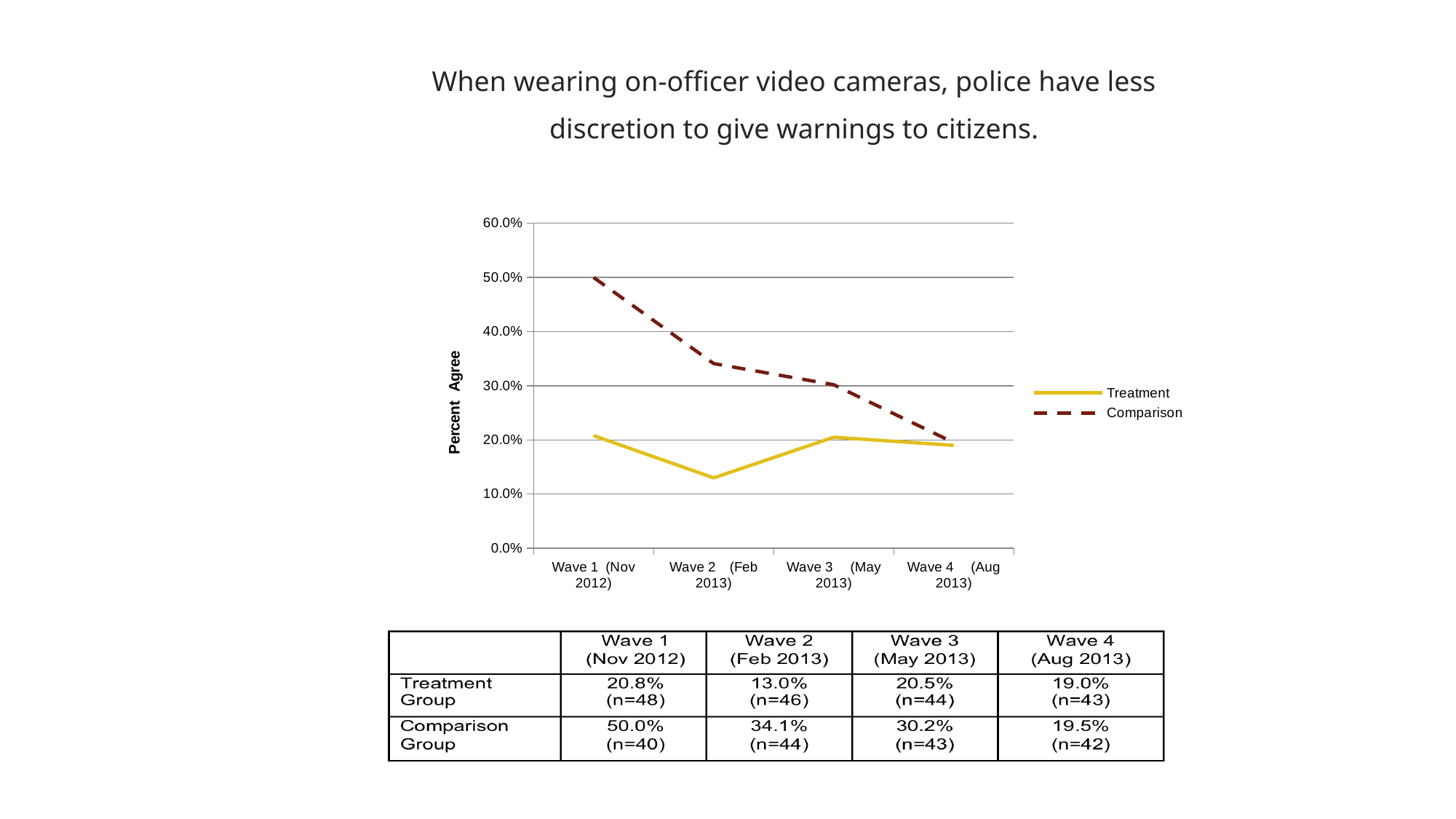
What is the Treatment group's percent agree at Wave 2 (Feb 2013)? 13.0% At which wave is the Treatment group's percent agree lowest? Wave 2 (Feb 2013) Is the Comparison group's value at Wave 2 (Feb 2013) greater or less than 30.0%? greater Does the Comparison group's percent agree rise or fall from Wave 1 to Wave 4? fall What is the difference between the Comparison and Treatment groups' percent agree at Wave 1 (Nov 2012)? 29.2% At which wave is the Comparison group's percent agree highest? Wave 1 (Nov 2012) What kind of chart is shown on the slide? line chart Which series is drawn with a dashed line in the chart? Comparison How many series does the chart's legend list? 2 How many waves (points) are plotted along the x axis of the chart? 4 Which series has the higher percent agree at Wave 3 (May 2013), Treatment or Comparison? Comparison What is the Comparison group's percent agree at Wave 1 (Nov 2012)? 50.0%